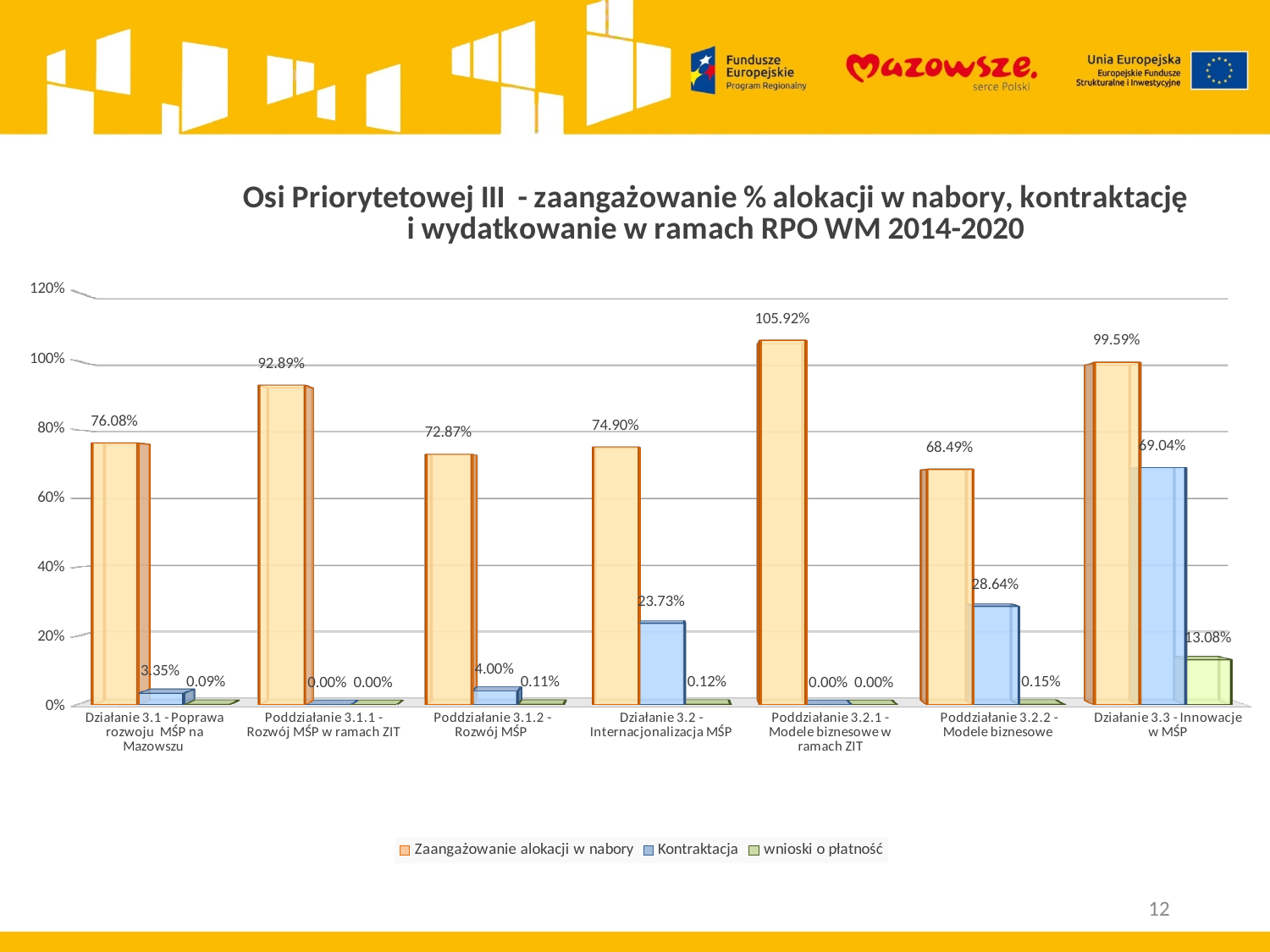
Which is larger: the Kontraktacja value for Działanie 3.2 - Internacjonalizacja MŚP or for Poddziałanie 3.2.2 - Modele biznesowe? Poddziałanie 3.2.2 - Modele biznesowe What is the difference between the Zaangażowanie alokacji w nabory values for Działanie 3.3 - Innowacje w MŚP and Działanie 3.1 - Poprawa rozwoju MŚP na Mazowszu? 23.51% How many series does the legend list? 3 What is the Kontraktacja value for Działanie 3.3 - Innowacje w MŚP? 69.04% What is the wnioski o płatność value for Poddziałanie 3.2.2 - Modele biznesowe? 0.15% Which series is shown in blue in the legend? Kontraktacja Which category has the lowest Zaangażowanie alokacji w nabory value? Poddziałanie 3.2.2 - Modele biznesowe What type of chart is shown on the slide? Bar chart Is the Zaangażowanie alokacji w nabory value for Poddziałanie 3.1.1 - Rozwój MŚP w ramach ZIT greater or less than 80%? greater What is the value of Zaangażowanie alokacji w nabory for Poddziałanie 3.2.1 - Modele biznesowe w ramach ZIT? 105.92% How many categories are shown on the x axis of the chart? 7 Which category has the highest Zaangażowanie alokacji w nabory value? Poddziałanie 3.2.1 - Modele biznesowe w ramach ZIT